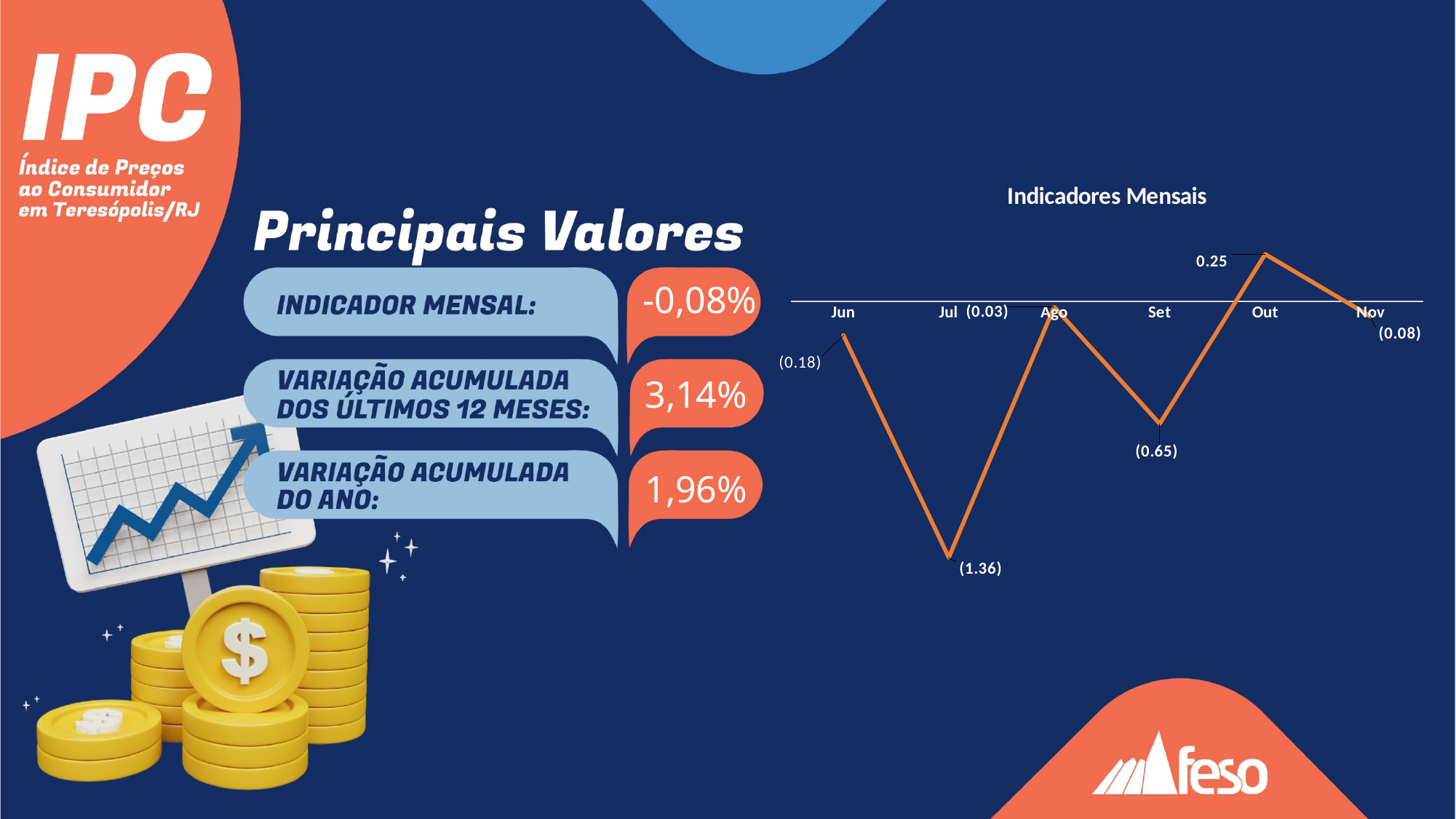
How many months are plotted in the "Indicadores Mensais" chart? 6 In the "Indicadores Mensais" chart, what is the value labelled for Out? 0.25 What kind of chart is shown under the title "Indicadores Mensais"? line chart In the "Indicadores Mensais" chart, what is the value labelled for Set? (0.65) In the "Indicadores Mensais" chart, which month has the highest value? Out In the "Indicadores Mensais" chart, does the line rise or fall from Set to Out? rise In the "Indicadores Mensais" chart, is the value for Out greater or less than 0? greater In the "Indicadores Mensais" chart, what is the value labelled for Nov? (0.08) In the "Indicadores Mensais" chart, what is the value labelled for Jul? (1.36) In the "Indicadores Mensais" chart, which month has the lowest value? Jul What is the title of the chart on the right side of the slide? Indicadores Mensais In the "Indicadores Mensais" chart, which month has the higher value, Ago or Set? Ago